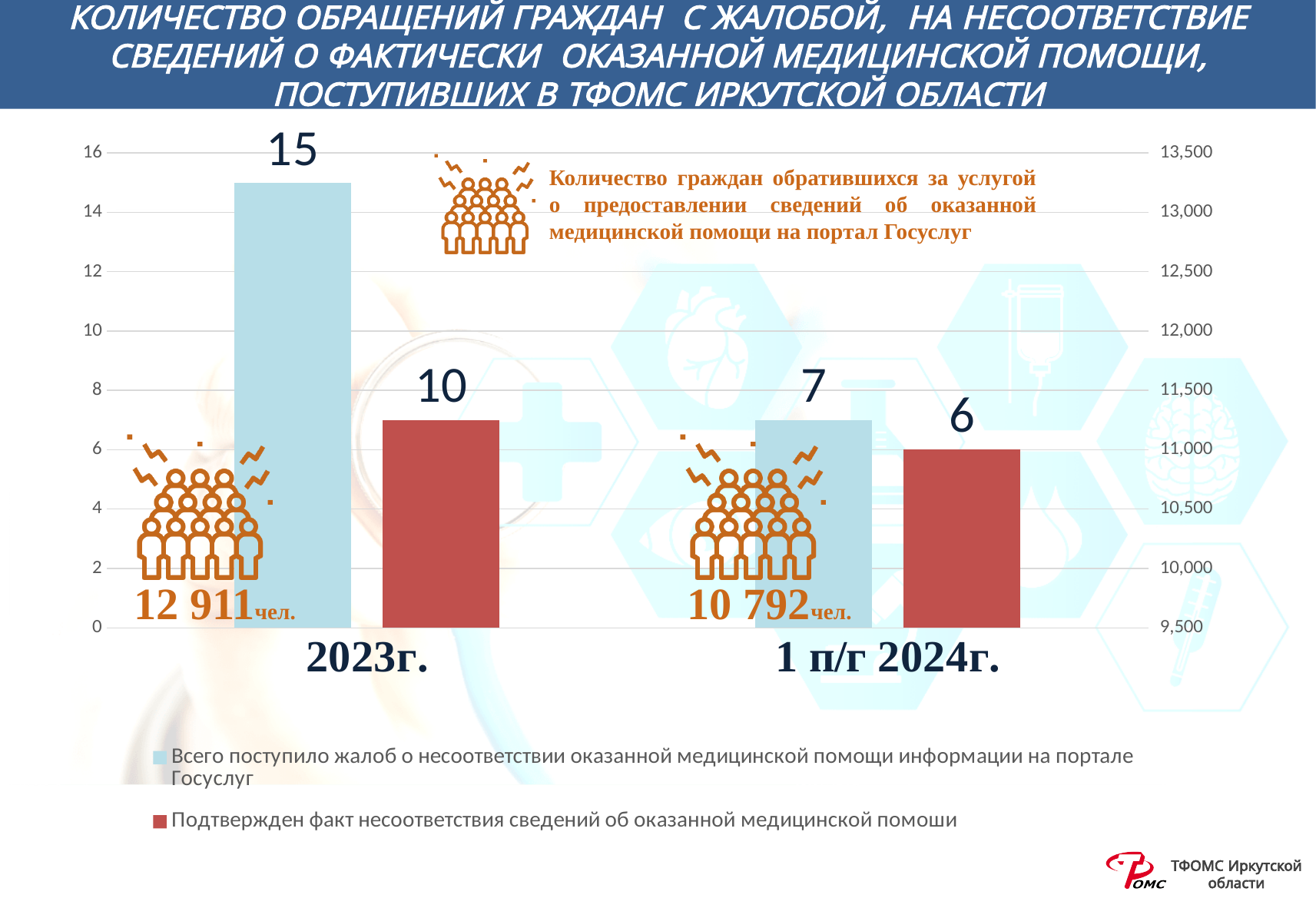
What is the value of the light blue bar (Всего поступило жалоб) for 2023г.? 15 What is the value of the light blue bar (Всего поступило жалоб) for 1 п/г 2024г.? 7 Which period has the highest value for the series Всего поступило жалоб? 2023г. What is the value of the red bar (Подтвержден факт несоответствия) for 1 п/г 2024г.? 6 What is the value of the red bar (Подтвержден факт несоответствия) for 2023г.? 10 How many series does the legend list? 2 What type of chart is shown on the slide? Bar chart Which period has the lowest value for the series Подтвержден факт несоответствия? 1 п/г 2024г. In 2023г., what is the difference between the complaints received and the confirmed cases? 5 What is the difference between the total complaints received (Всего поступило жалоб) in 2023г. and in 1 п/г 2024г.? 8 Which is larger in 1 п/г 2024г.: the complaints received (light blue) or the confirmed cases (red)? Complaints received (light blue), 7 How many citizens applied for the service on the Gosuslugi portal in 2023г., according to the annotation on the chart? 12 911 чел.